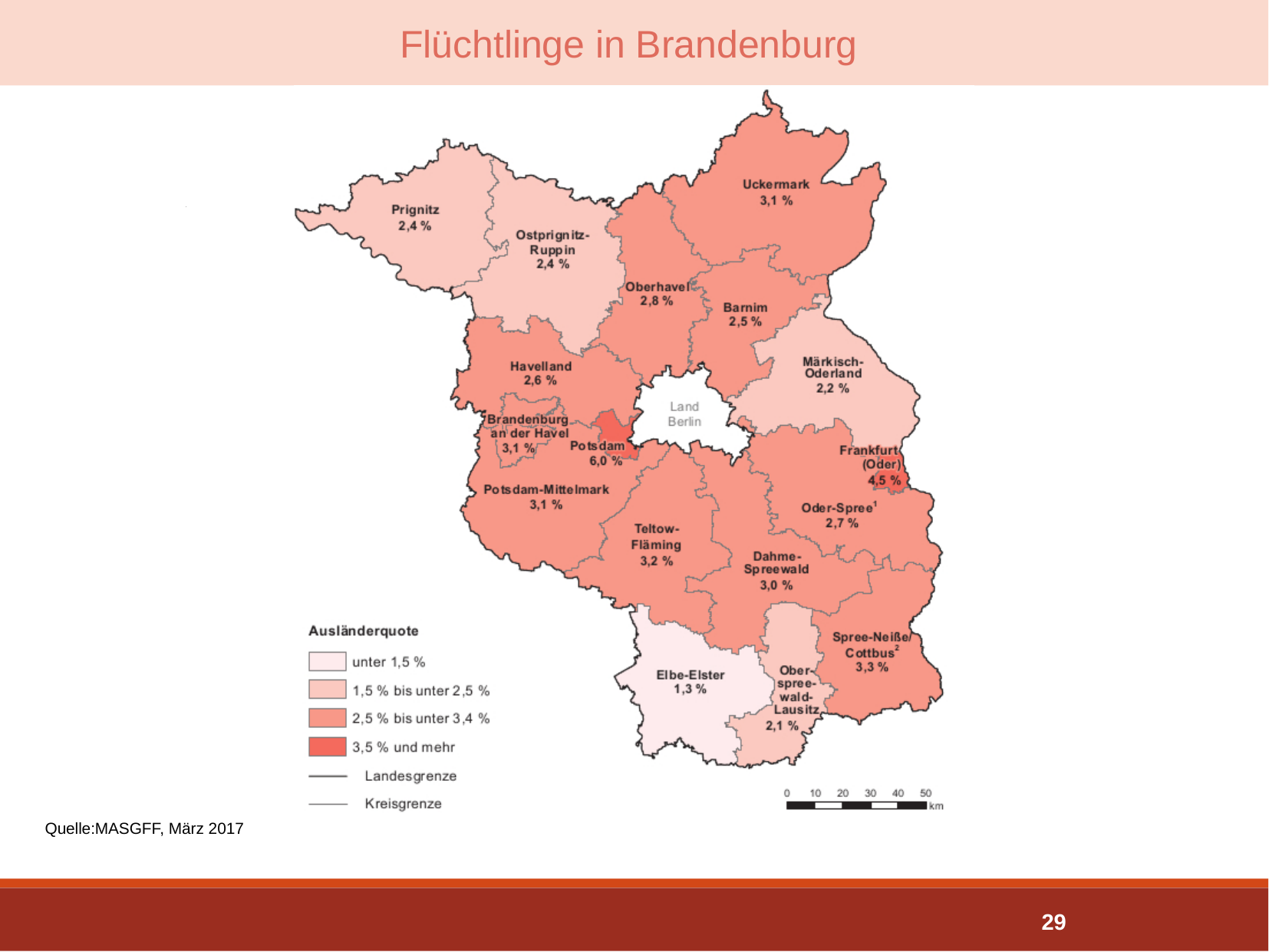
What kind of chart is shown on the slide? A map (choropleth map) What is the difference between the Ausländerquote of Potsdam and Frankfurt (Oder)? 1,5 % What is the Ausländerquote shown for Uckermark? 3,1 % What is the title of the slide? Flüchtlinge in Brandenburg Which region on the map has the highest Ausländerquote? Potsdam What is the Ausländerquote shown for Frankfurt (Oder)? 4,5 % Which has a higher Ausländerquote, Teltow-Fläming or Märkisch-Oderland? Teltow-Fläming What source is given for the map? MASGFF, März 2017 What is the Ausländerquote shown for Elbe-Elster? 1,3 % Which region on the map has the lowest Ausländerquote? Elbe-Elster What is the Ausländerquote shown for Potsdam? 6,0 % How many colour classes does the Ausländerquote legend list? 4